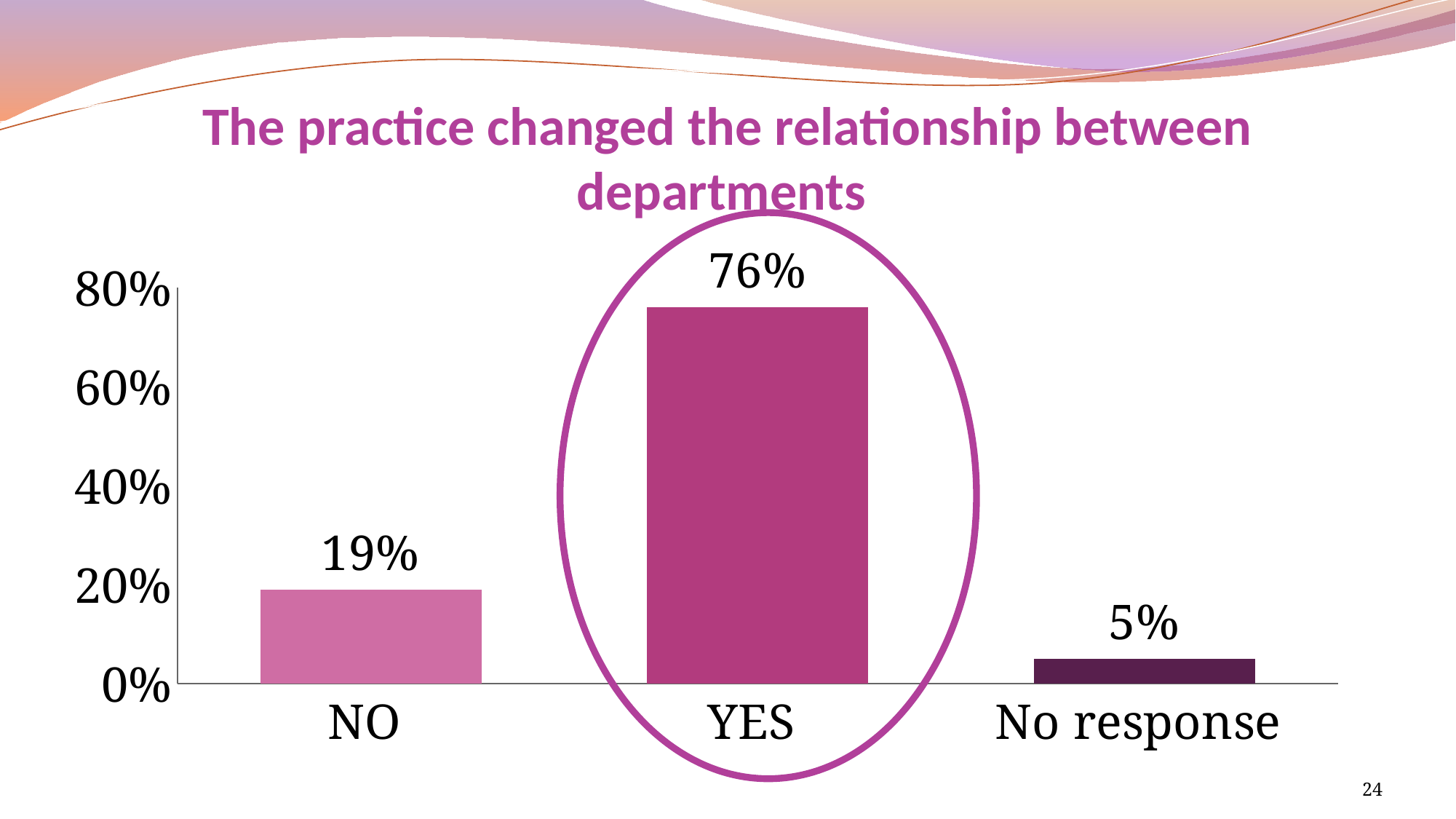
What is the difference between the values for NO and No response? 14% What kind of chart is shown on the slide? bar chart What is the value for No response? 5% Which category has the highest value? YES What is the difference between the values for YES and NO? 57% Which is larger, the value for NO or the value for No response? NO What is the value for YES? 76% What is the title of the chart? The practice changed the relationship between departments What is the value for NO? 19% Which category has the lowest value? No response Is the value for YES greater or less than 60%? greater How many categories are shown on the x axis? 3